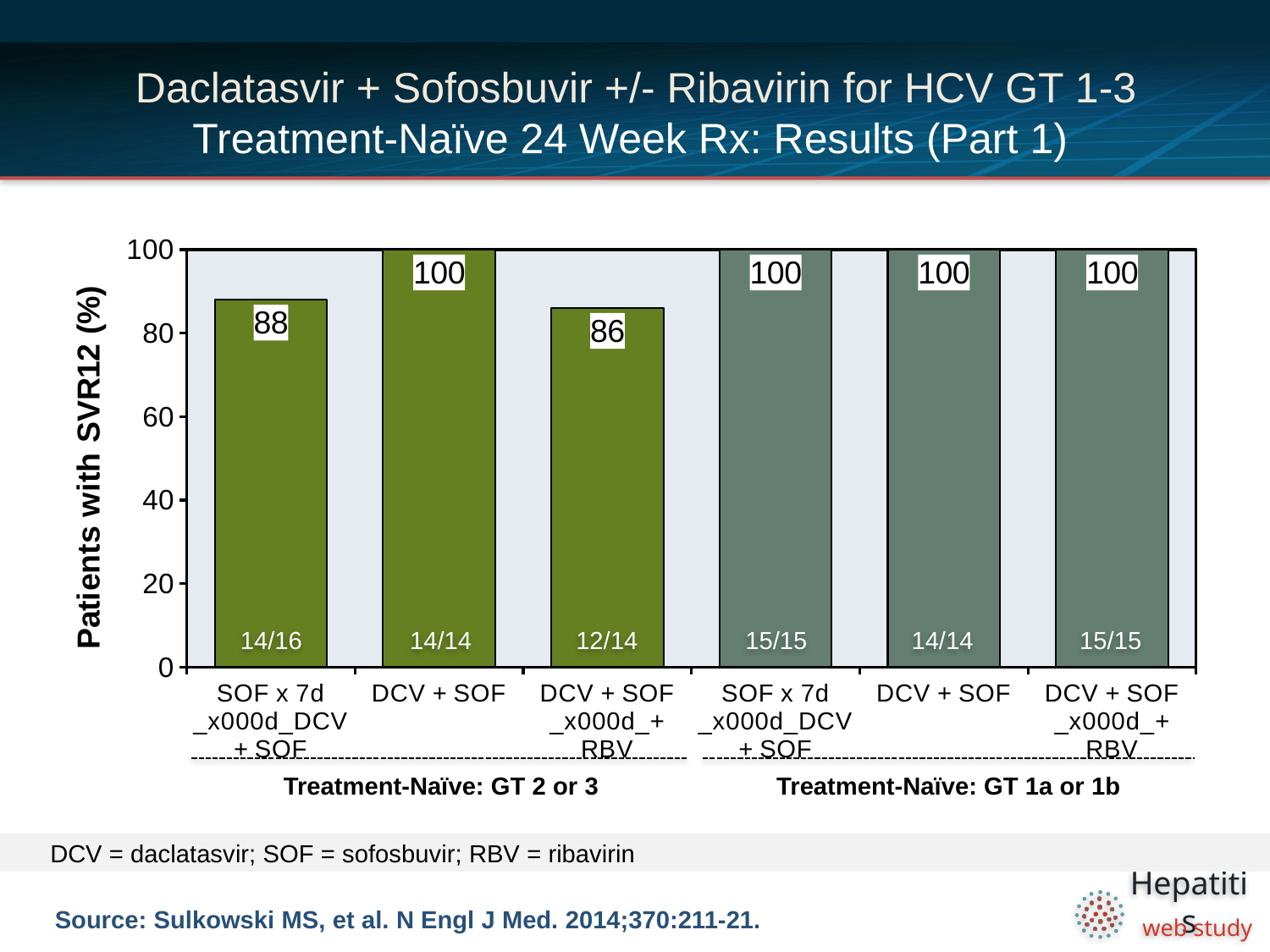
What is the label of the y-axis? Patients with SVR12 (%) Which is larger: the SVR12 percentage for the SOF x 7d followed by DCV + SOF arm in the GT 2 or 3 group, or the same arm in the GT 1a or 1b group? GT 1a or 1b What patient fraction is shown on the DCV + SOF + RBV bar in the Treatment-Naïve: GT 2 or 3 group? 12/14 What is the SVR12 percentage for the DCV + SOF arm in the Treatment-Naïve: GT 1a or 1b group? 100 What is the difference in SVR12 percentage between the DCV + SOF arm and the DCV + SOF + RBV arm in the Treatment-Naïve: GT 2 or 3 group? 14 How many arms in the Treatment-Naïve: GT 1a or 1b group achieved 100% SVR12? 3 What type of chart is shown on the slide? Bar chart What patient fraction is shown on the SOF x 7d followed by DCV + SOF bar in the Treatment-Naïve: GT 1a or 1b group? 15/15 What is the SVR12 percentage for the SOF x 7d followed by DCV + SOF arm in the Treatment-Naïve: GT 2 or 3 group? 88 Which arm has the lowest SVR12 percentage on the chart? DCV + SOF + RBV (Treatment-Naïve: GT 2 or 3) What is the SVR12 percentage for the DCV + SOF + RBV arm in the Treatment-Naïve: GT 2 or 3 group? 86 How many bars are plotted on the chart? 6